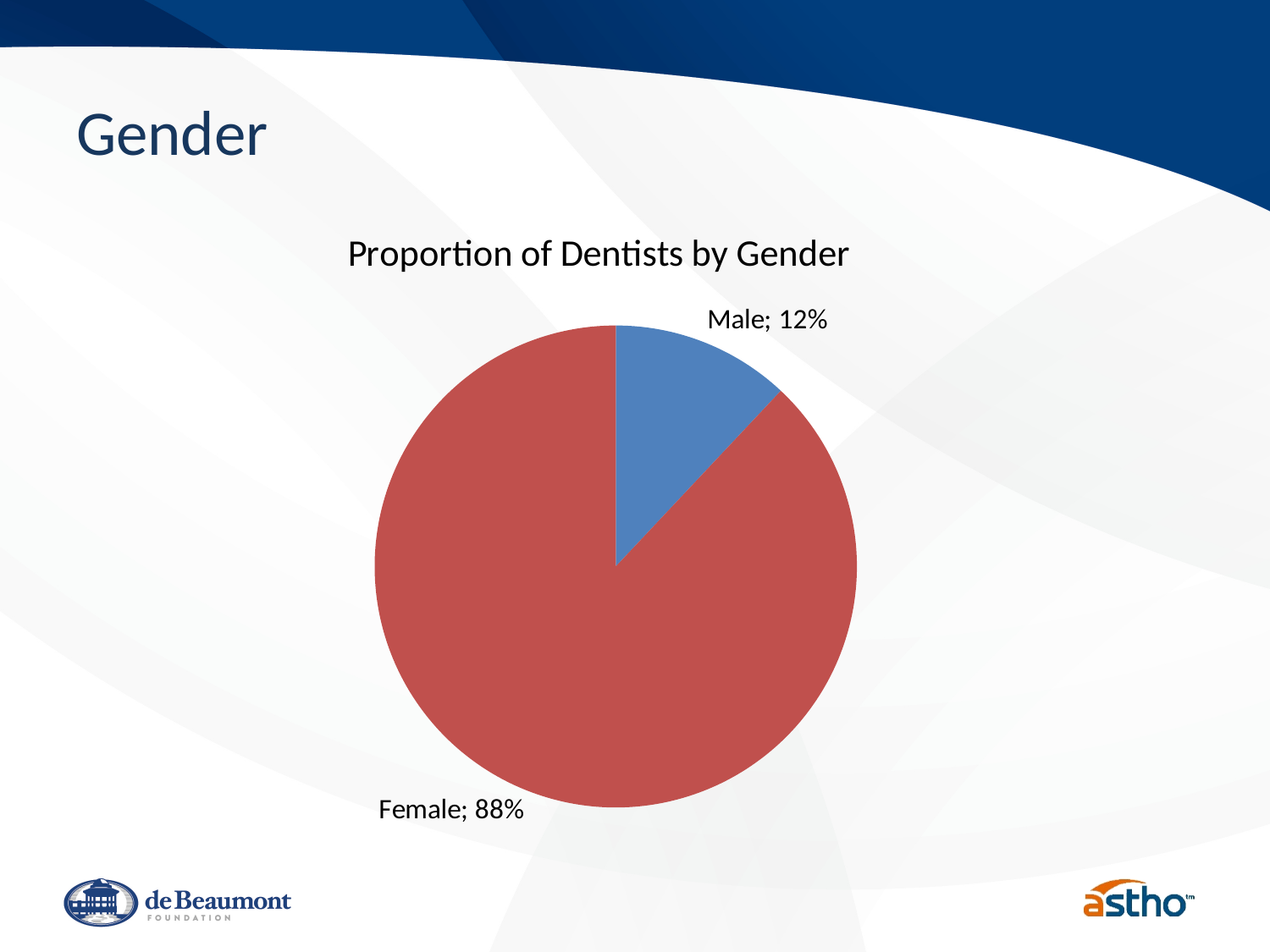
Which share is larger in the pie chart, Male or Female? Female What percentage of dentists are female according to the pie chart? 88% Which gender has the largest share of dentists in the pie chart? Female What kind of chart is shown on the slide? Pie chart What colour is the Female slice in the pie chart? Red Which gender has the smallest share of dentists in the pie chart? Male What percentage of dentists are male according to the pie chart? 12% What share of the pie does the Male slice represent? 12% How many slices does the pie chart have? 2 What is the difference in percentage points between the female and male shares of dentists? 76 What is the title of the chart on the slide? Proportion of Dentists by Gender